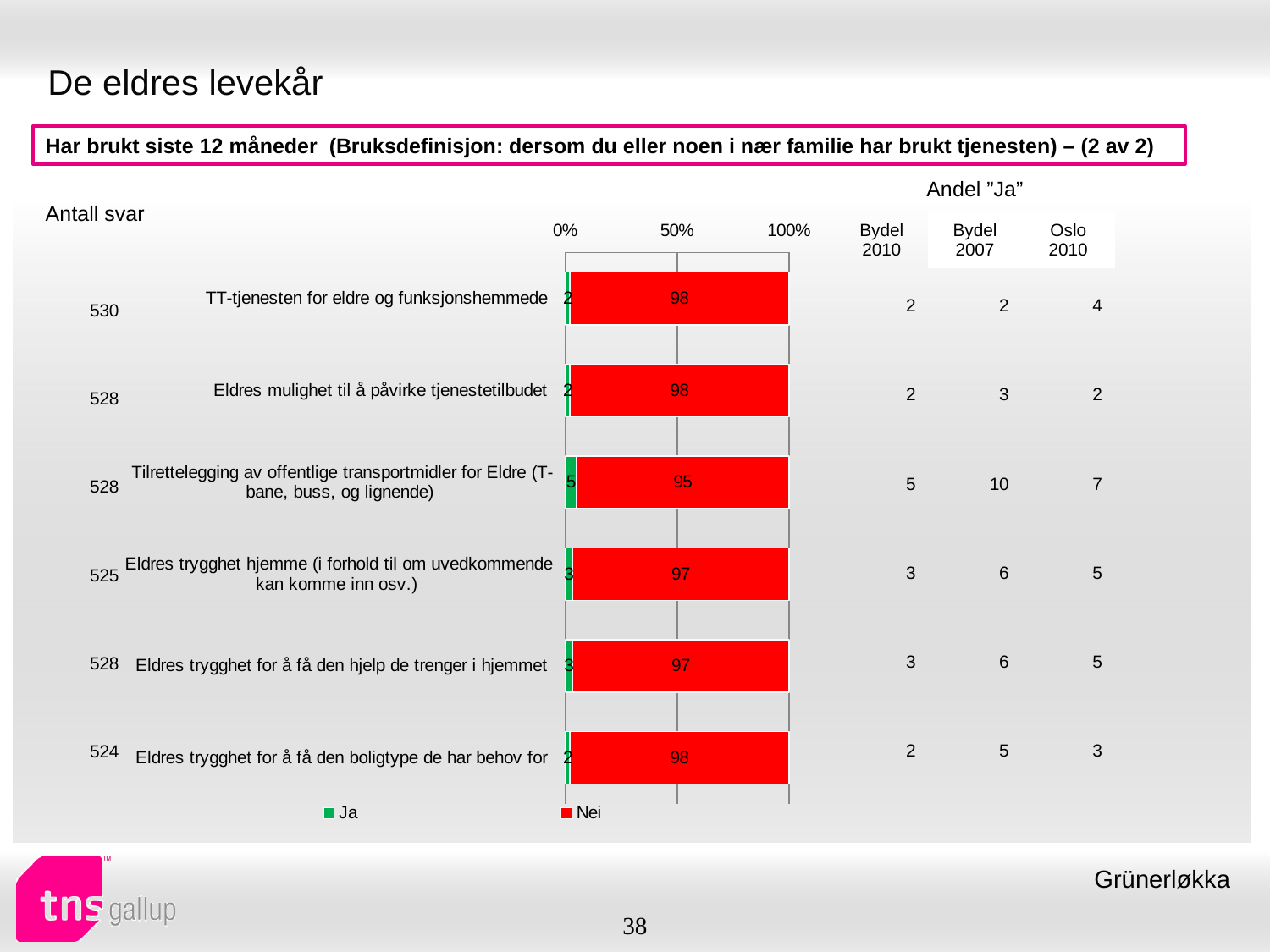
What is the "Nei" value for "Tilrettelegging av offentlige transportmidler for Eldre (T-bane, buss, og lignende)"? 95 Which is larger: the "Nei" value for "Eldres trygghet hjemme (i forhold til om uvedkommende kan komme inn osv.)" or the "Nei" value for "Eldres trygghet for å få den boligtype de har behov for"? Eldres trygghet for å få den boligtype de har behov for What is the difference between the "Nei" values for "TT-tjenesten for eldre og funksjonshemmede" and "Tilrettelegging av offentlige transportmidler for Eldre (T-bane, buss, og lignende)"? 3 Which category has the highest "Ja" value? Tilrettelegging av offentlige transportmidler for Eldre (T-bane, buss, og lignende) Which series in the legend is shown in red? Nei How many series does the chart legend list? 2 What is the "Nei" value for "Eldres trygghet for å få den hjelp de trenger i hjemmet"? 97 How many categories are plotted in the chart? 6 Which category has the lowest "Nei" value? Tilrettelegging av offentlige transportmidler for Eldre (T-bane, buss, og lignende) What kind of chart is shown on the slide? bar chart What is the "Ja" value for "Tilrettelegging av offentlige transportmidler for Eldre (T-bane, buss, og lignende)"? 5 What is the "Nei" value for "TT-tjenesten for eldre og funksjonshemmede"? 98